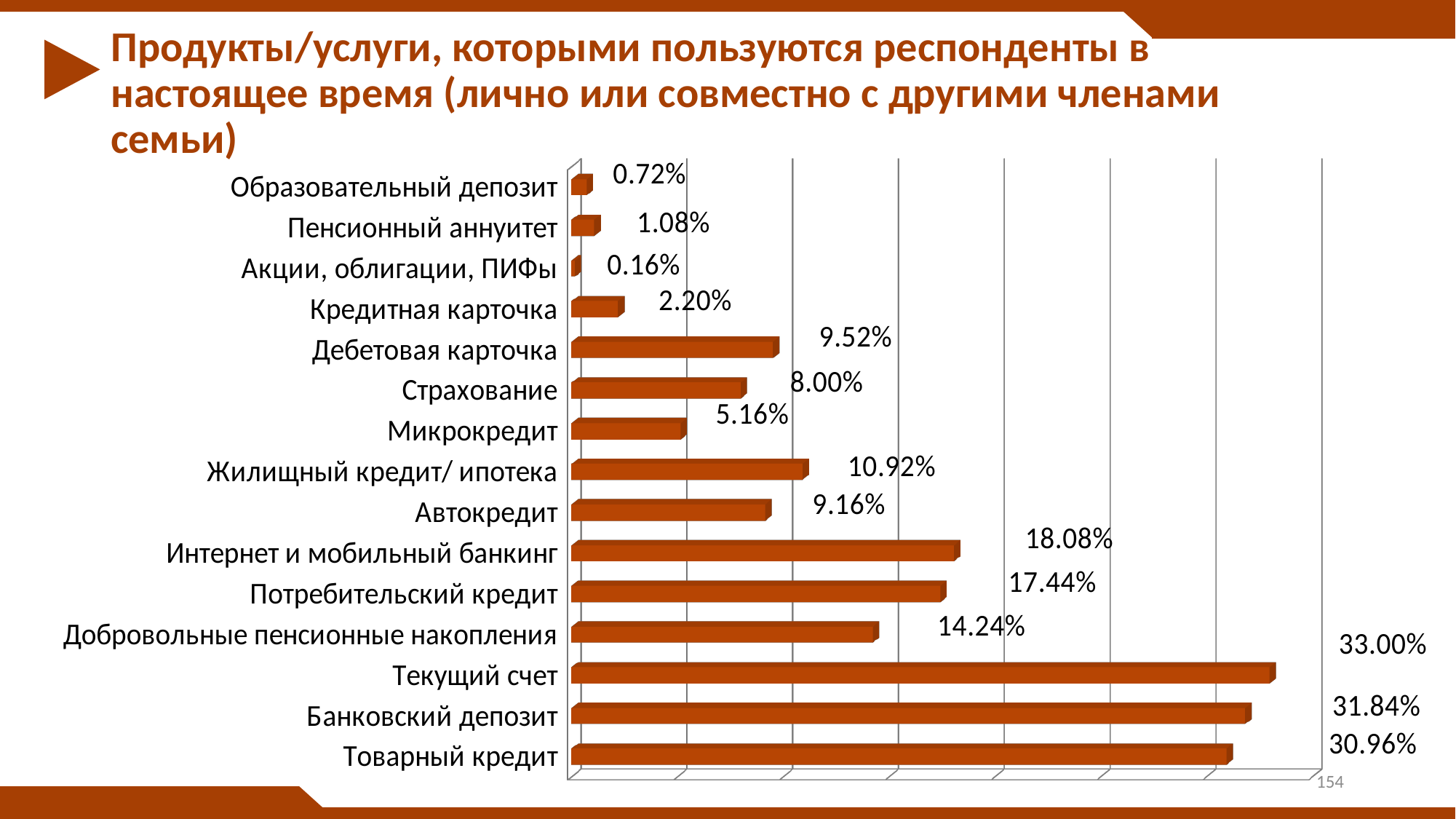
What value is shown for Интернет и мобильный банкинг? 18.08% Which category has the lowest value? Акции, облигации, ПИФы What kind of chart is shown on the slide? Bar chart What value is shown for Жилищный кредит/ ипотека? 10.92% What is the difference between the values for Интернет и мобильный банкинг and Потребительский кредит? 0.64% What value is shown for Текущий счет? 33.00% What value is shown for Кредитная карточка? 2.20% Which is larger, the value for Дебетовая карточка or the value for Автокредит? Дебетовая карточка Which category has the highest value? Текущий счет Which is larger, the value for Страхование or the value for Микрокредит? Страхование How many categories are shown in the chart? 15 What is the difference between the values for Текущий счет and Банковский депозит? 1.16%